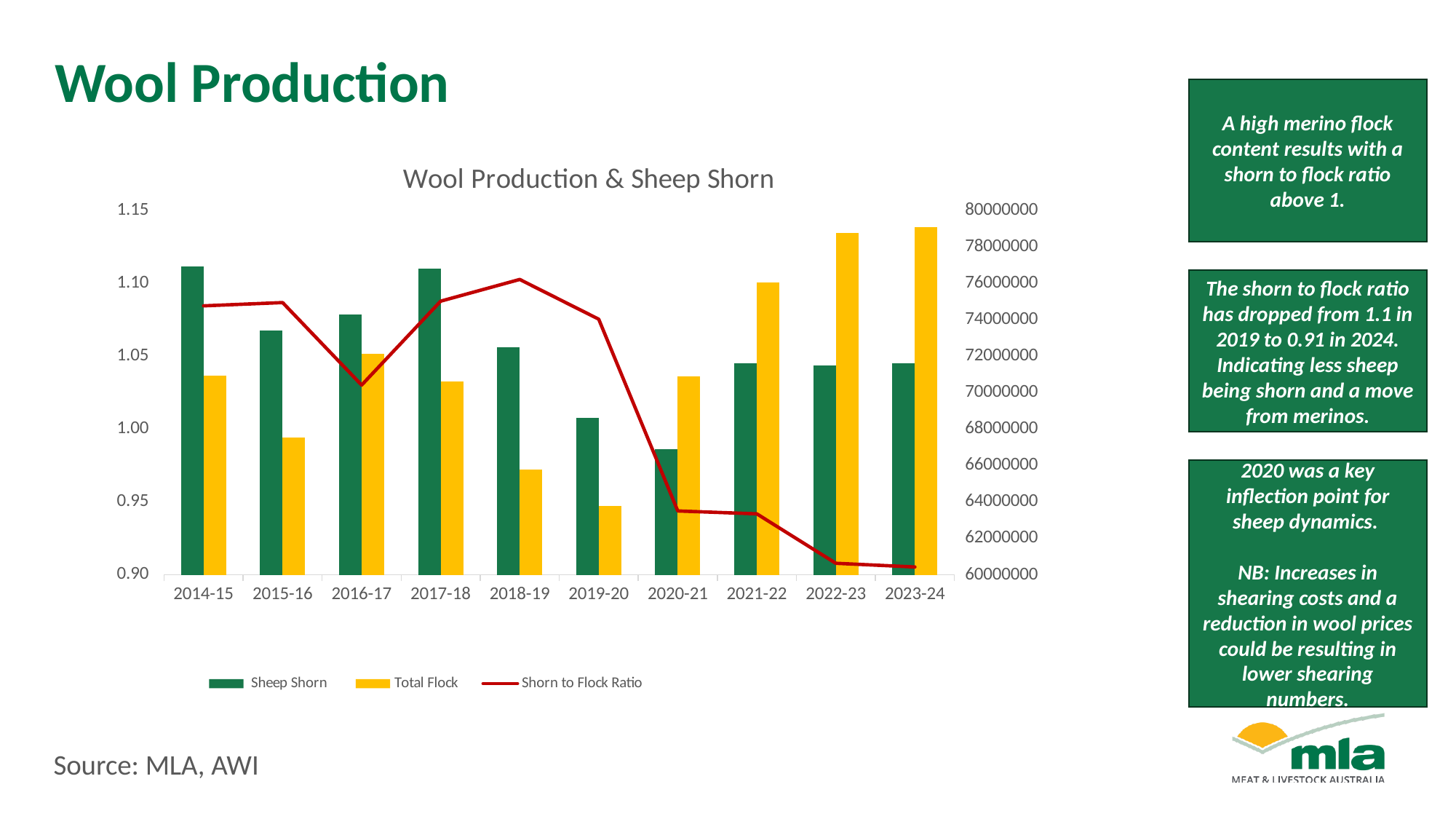
Is the Sheep Shorn value for 2020-21 greater or less than 68000000? less How many financial years are shown on the x axis? 10 In 2023-24, which is larger: Sheep Shorn or Total Flock? Total Flock What kind of chart is shown on the slide? A combination bar and line chart In which year is the Total Flock bar lowest? 2019-20 Is the Total Flock value for 2023-24 greater or less than 78000000? greater What is the title of the chart? Wool Production & Sheep Shorn In which year is the Shorn to Flock Ratio highest? 2018-19 In which year is the Sheep Shorn bar lowest? 2020-21 Is the Shorn to Flock Ratio for 2022-23 greater or less than 0.95? less How many series does the legend list? 3 Which series is drawn as a red line? Shorn to Flock Ratio